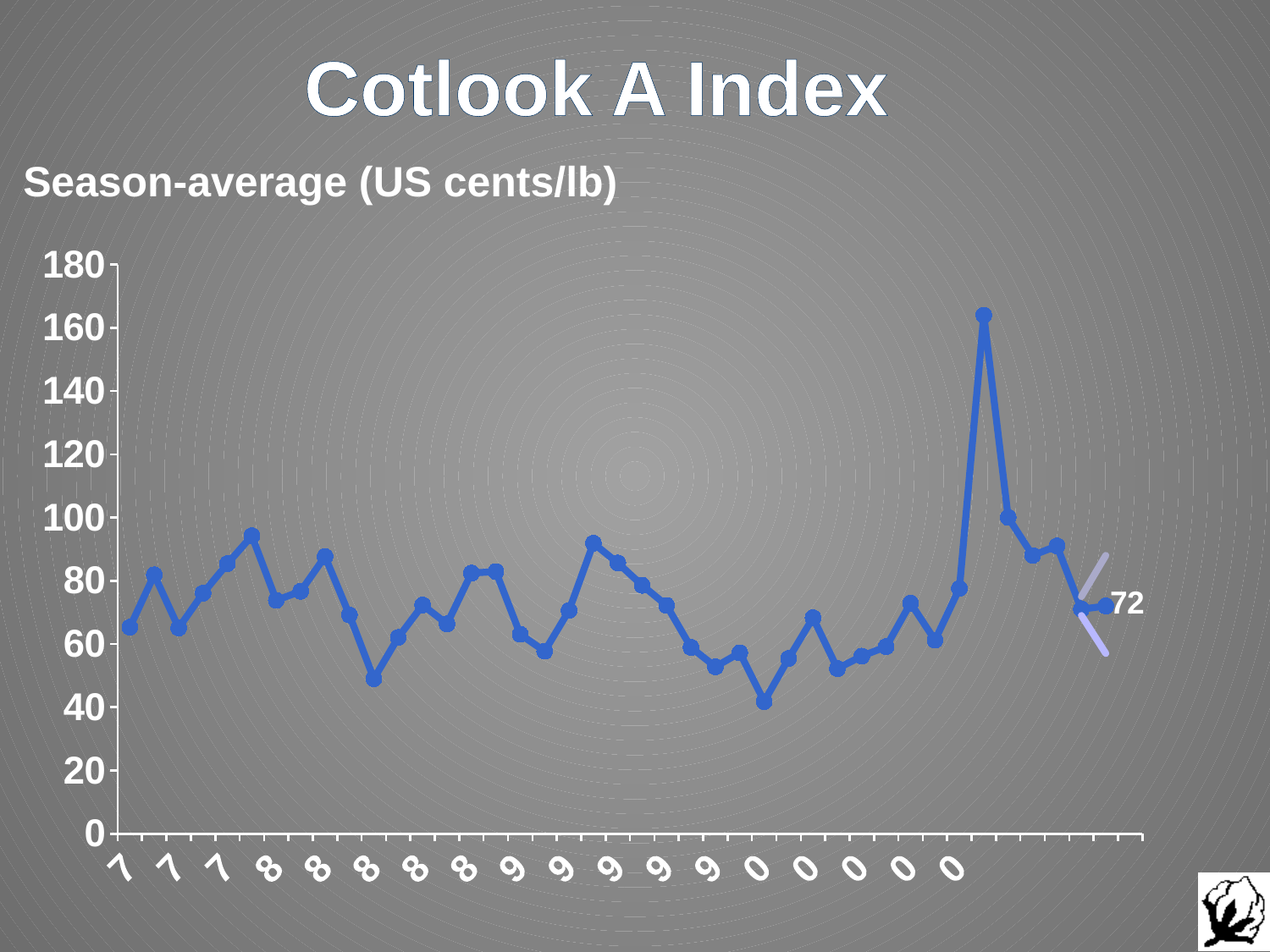
What is the value of the last (most recent) data point on the line? 72 Is the lowest point on the line greater or less than 60? less What is the maximum value shown on the vertical axis? 180 Is the highest point on the line greater or less than 140? greater Is the last data point (labelled 72) greater or less than 100? less Does the line rise or fall from its highest peak to the final data point? fall What is the title of the chart? Cotlook A Index What kind of chart is shown on the slide? line chart In what units is the season-average Cotlook A Index plotted? US cents/lb